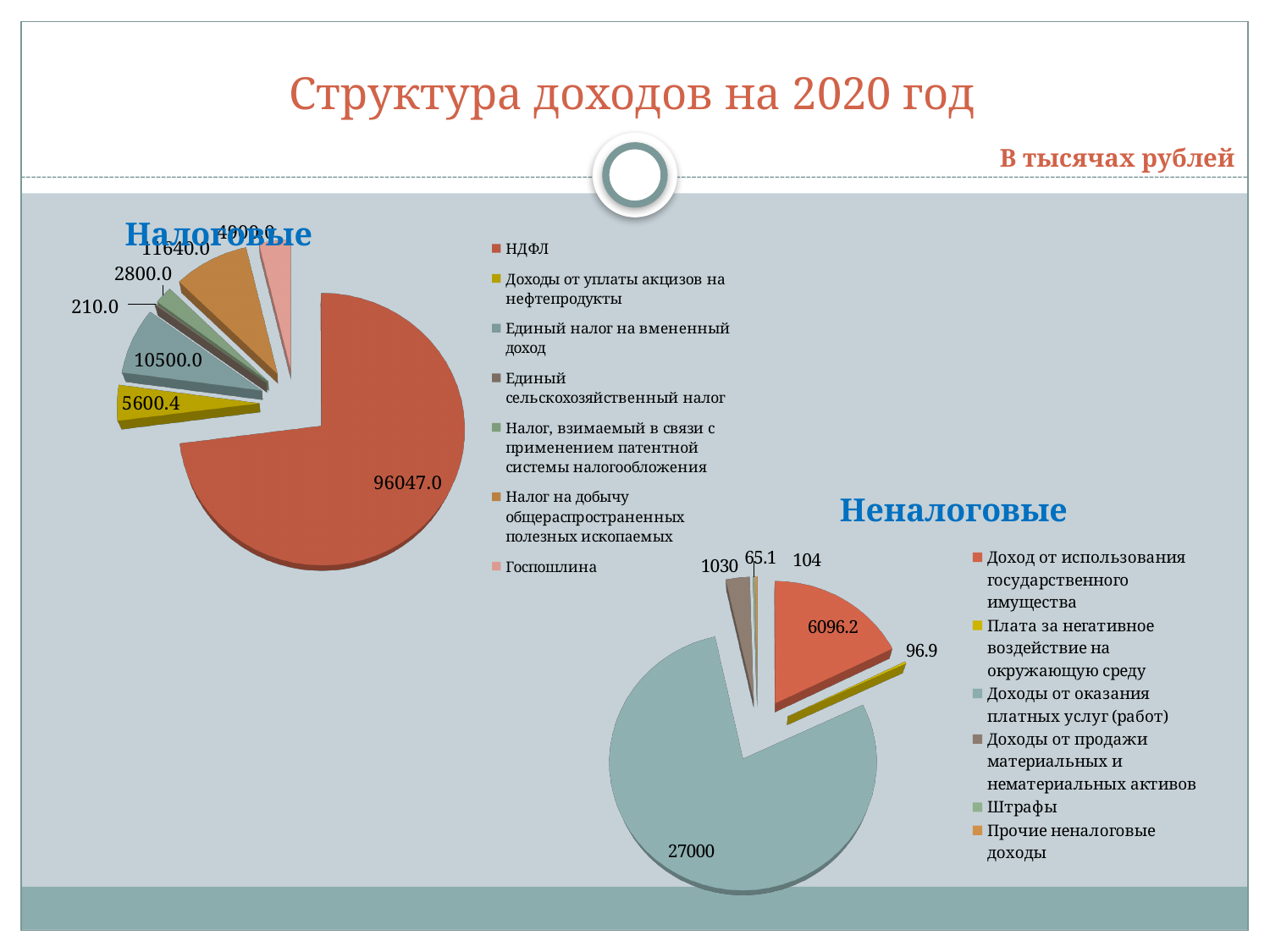
How many categories does the legend of the "Неналоговые" chart list? 6 What kind of chart is the "Налоговые" chart? pie chart In the "Неналоговые" chart, what is the value for Плата за негативное воздействие на окружающую среду? 96.9 In the "Неналоговые" chart, what is the value for Доходы от оказания платных услуг (работ)? 27000 In the "Налоговые" chart, which category has the largest value? НДФЛ In the "Неналоговые" chart, what is the difference between Доход от использования государственного имущества (6096.2) and Доходы от продажи материальных и нематериальных активов (1030)? 5066.2 In the "Налоговые" chart, which is larger: Налог на добычу общераспространенных полезных ископаемых or Единый налог на вмененный доход? Налог на добычу общераспространенных полезных ископаемых In the "Налоговые" chart, which category has the smallest value? Единый сельскохозяйственный налог In the "Налоговые" chart, what is the value for НДФЛ? 96047.0 In the "Налоговые" chart, what is the value for Единый налог на вмененный доход? 10500.0 In the "Неналоговые" chart, which category has the smallest value? Штрафы In the "Налоговые" chart, what is the difference between Налог на добычу общераспространенных полезных ископаемых (11640.0) and Единый налог на вмененный доход (10500.0)? 1140.0